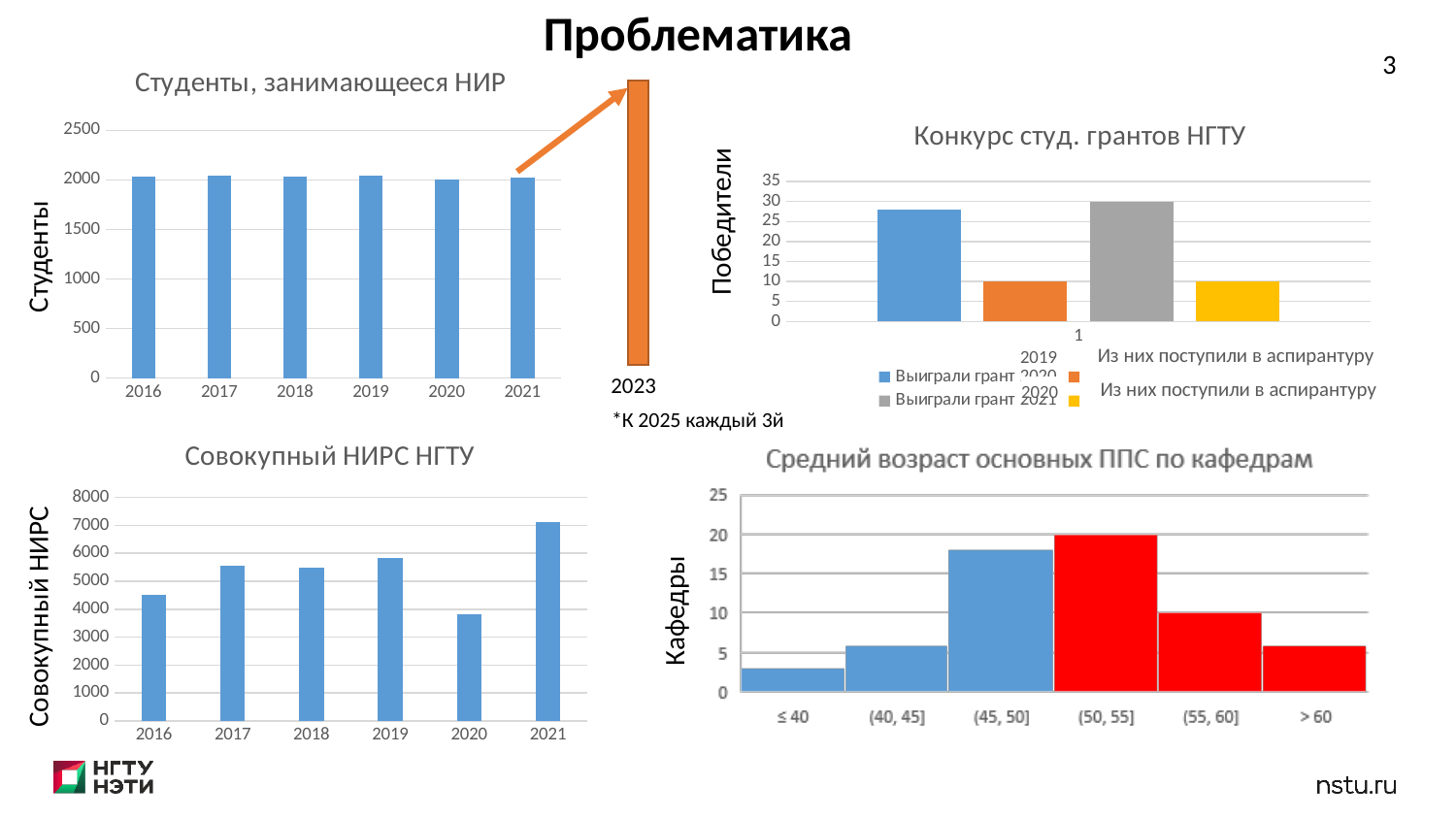
In the chart 'Совокупный НИРС НГТУ', which year has the highest value? 2021 In the chart 'Средний возраст основных ППС по кафедрам', which age group has the highest number of departments? (50, 55] In the chart 'Средний возраст основных ППС по кафедрам', which age group has the lowest number of departments? ≤ 40 What kind of chart is 'Студенты, занимающееся НИР'? bar chart In the chart 'Средний возраст основных ППС по кафедрам', is the value for (45, 50] greater or less than 15? greater In the chart 'Конкурс студ. грантов НГТУ', how many entries does the legend list? 4 In the chart 'Средний возраст основных ППС по кафедрам', how many age groups are shown on the x axis? 6 In the chart 'Совокупный НИРС НГТУ', which year has the lowest value? 2020 In the chart 'Конкурс студ. грантов НГТУ', is the value for 'Выиграли грант 2021' greater or less than 25? greater In the chart 'Средний возраст основных ППС по кафедрам', what is the value for the (55, 60] group? 10 In the chart 'Совокупный НИРС НГТУ', is the value for 2020 greater or less than 4000? less In the chart 'Средний возраст основных ППС по кафедрам', what is the value for the (50, 55] group? 20